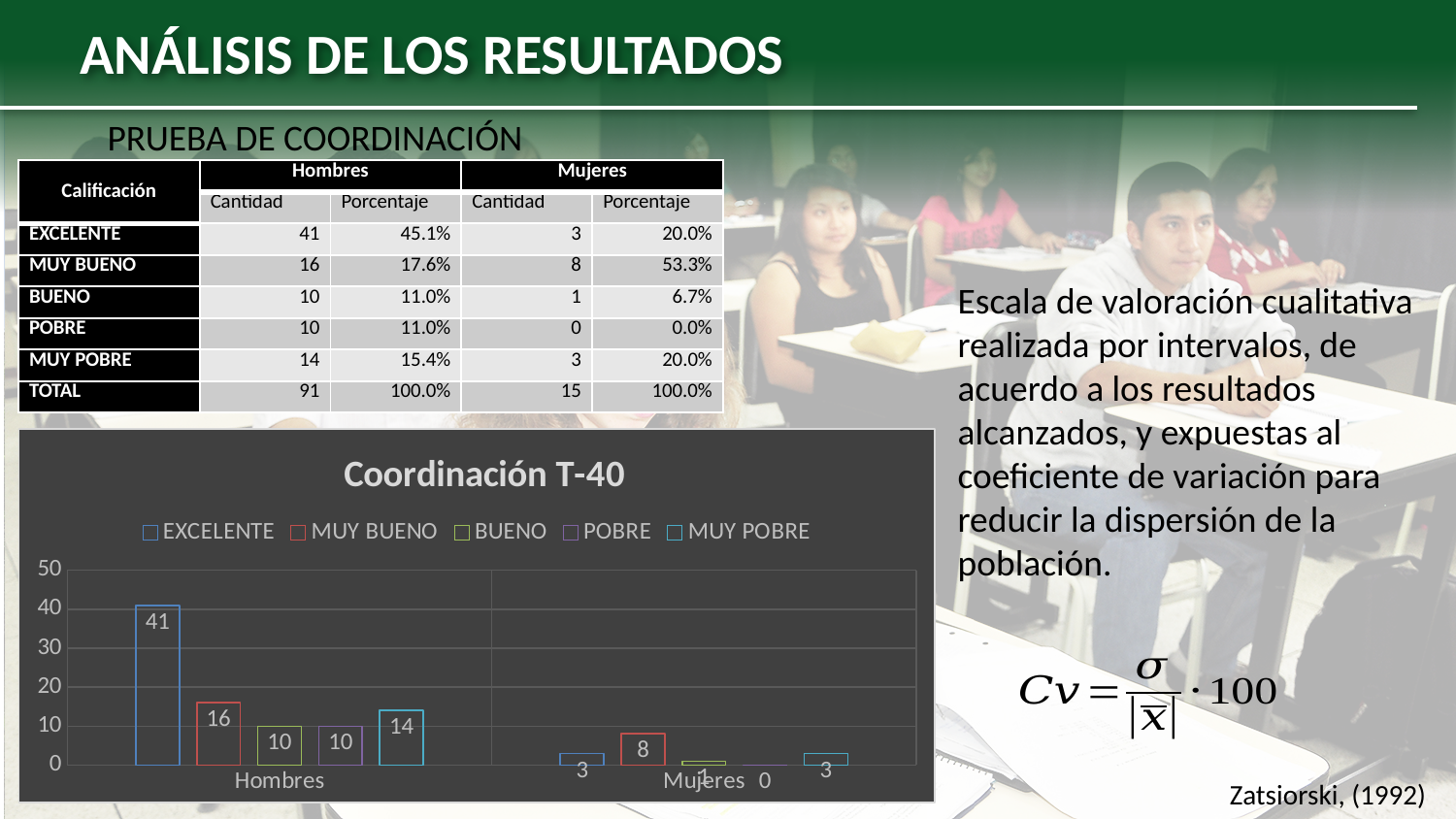
Which is larger: the MUY BUENO value for Mujeres or the EXCELENTE value for Mujeres? MUY BUENO value for Mujeres What is the value for MUY BUENO in the Mujeres category? 8 What is the value for MUY POBRE in the Hombres category? 14 What is the value for EXCELENTE in the Hombres category? 41 Which series has the lowest value in the Mujeres category? POBRE Which series has the highest value in the Hombres category? EXCELENTE What type of chart is shown on the slide? bar chart What is the difference between the EXCELENTE value for Hombres and the MUY BUENO value for Hombres? 25 Is the value for EXCELENTE in the Hombres category greater or less than 30? greater What is the title of the chart? Coordinación T-40 How many series does the chart legend list? 5 How many categories are shown on the x axis of the chart? 2